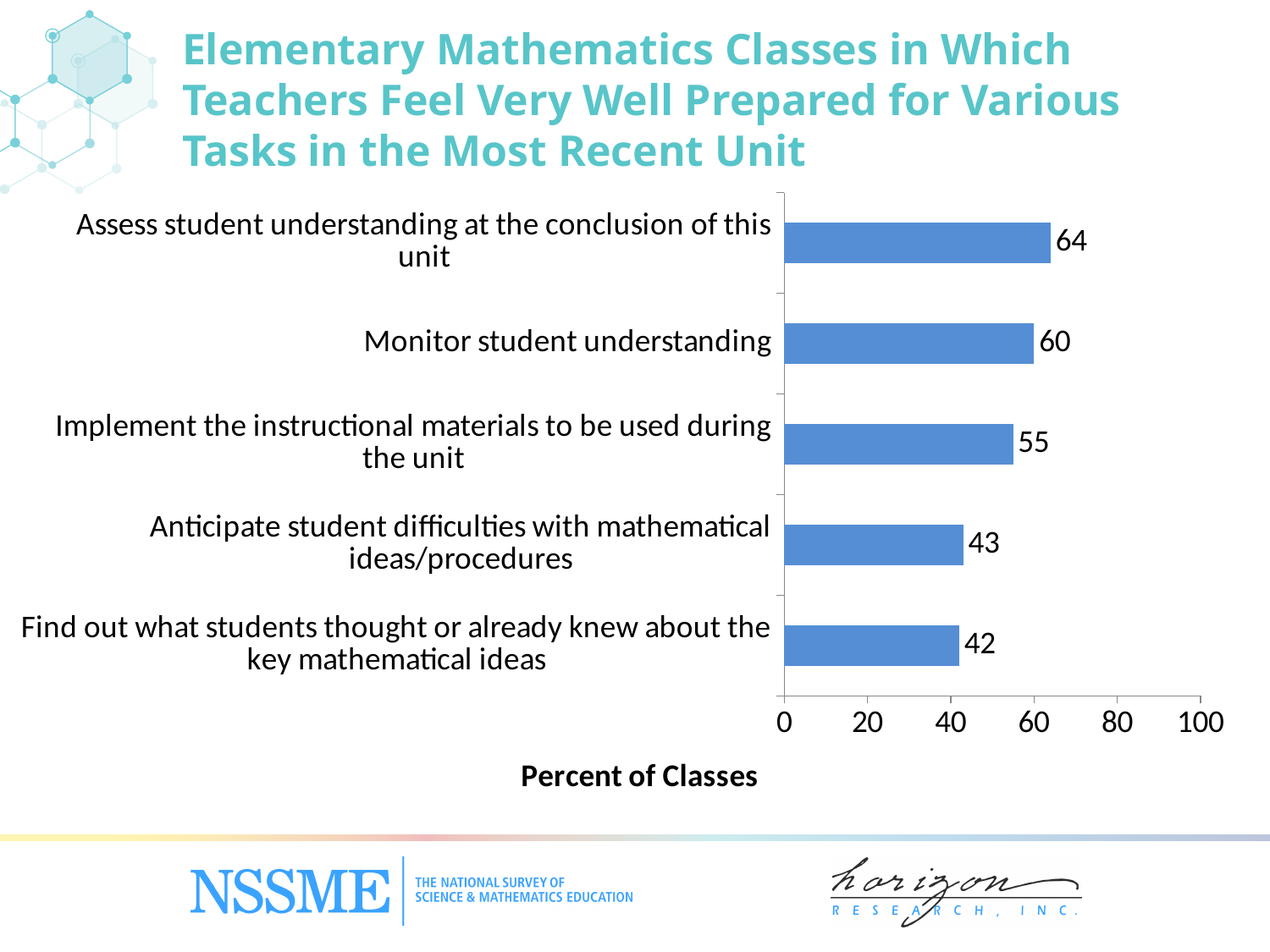
What is the value for 'Anticipate student difficulties with mathematical ideas/procedures'? 43 Is the value for 'Assess student understanding at the conclusion of this unit' greater or less than 60? greater What is the value for 'Find out what students thought or already knew about the key mathematical ideas'? 42 What percent of classes have teachers who feel very well prepared to monitor student understanding? 60 Which task has the lowest percent of classes? Find out what students thought or already knew about the key mathematical ideas What is the label of the horizontal axis? Percent of Classes Which is larger: the value for 'Monitor student understanding' or the value for 'Implement the instructional materials to be used during the unit'? Monitor student understanding What is the maximum value shown on the horizontal axis? 100 How many tasks are shown in the chart? 5 What is the difference between the values for 'Assess student understanding at the conclusion of this unit' and 'Implement the instructional materials to be used during the unit'? 9 What kind of chart is shown on the slide? bar chart Which task has the highest percent of classes? Assess student understanding at the conclusion of this unit